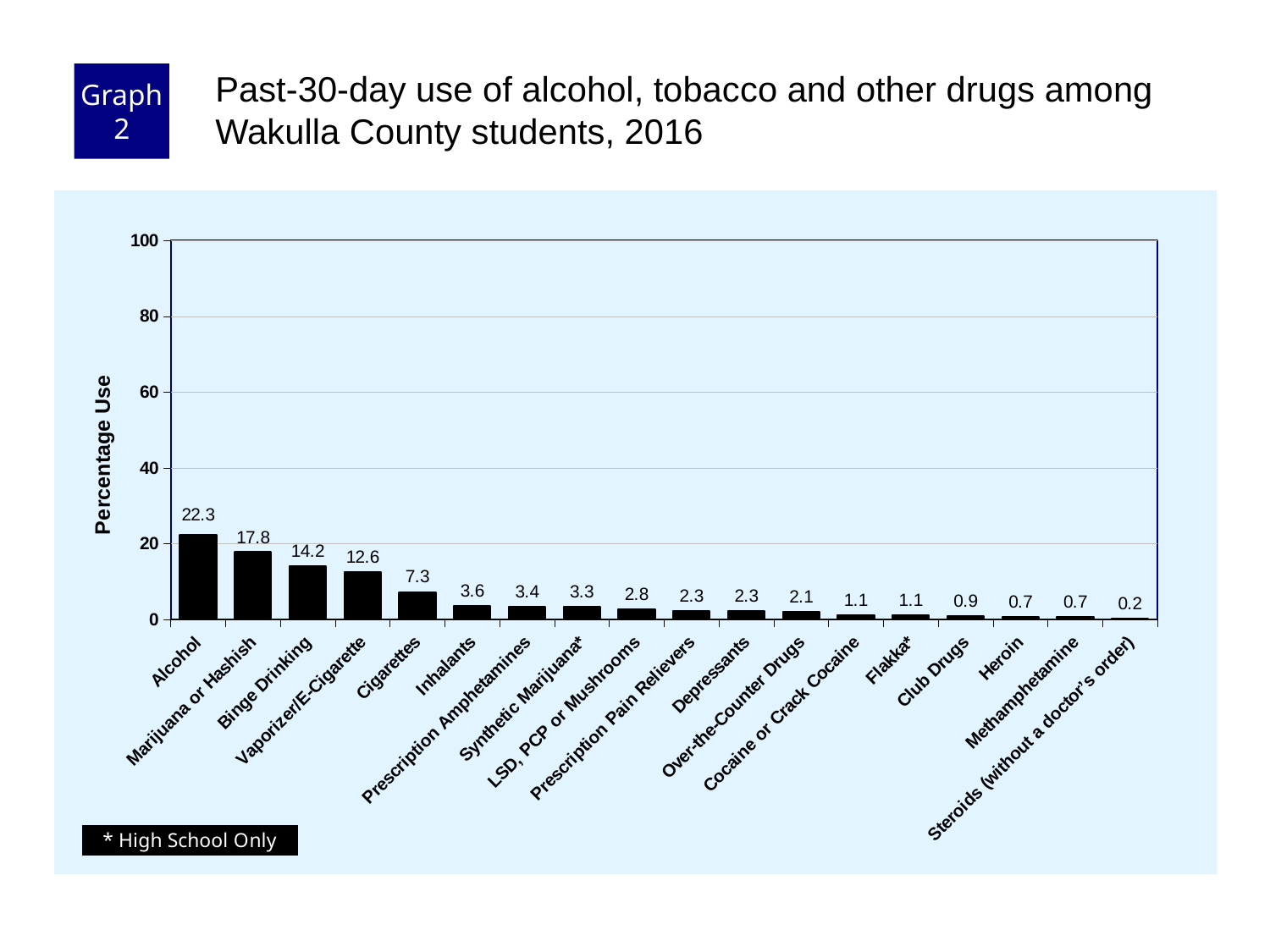
What kind of chart is shown on the slide? bar chart Is the value for Marijuana or Hashish greater or less than 20? less Which category has the highest percentage use? Alcohol Which category has the lowest percentage use? Steroids (without a doctor's order) How many categories are shown on the x axis? 18 Which is larger, the value for Binge Drinking or the value for Cigarettes? Binge Drinking What is the value shown for Vaporizer/E-Cigarette? 12.6 What is the value shown for Cigarettes? 7.3 What is the past-30-day use percentage for Alcohol? 22.3 What is the value shown for Heroin? 0.7 What is the difference between the values for Alcohol and Marijuana or Hashish? 4.5 What is the label of the y axis? Percentage Use